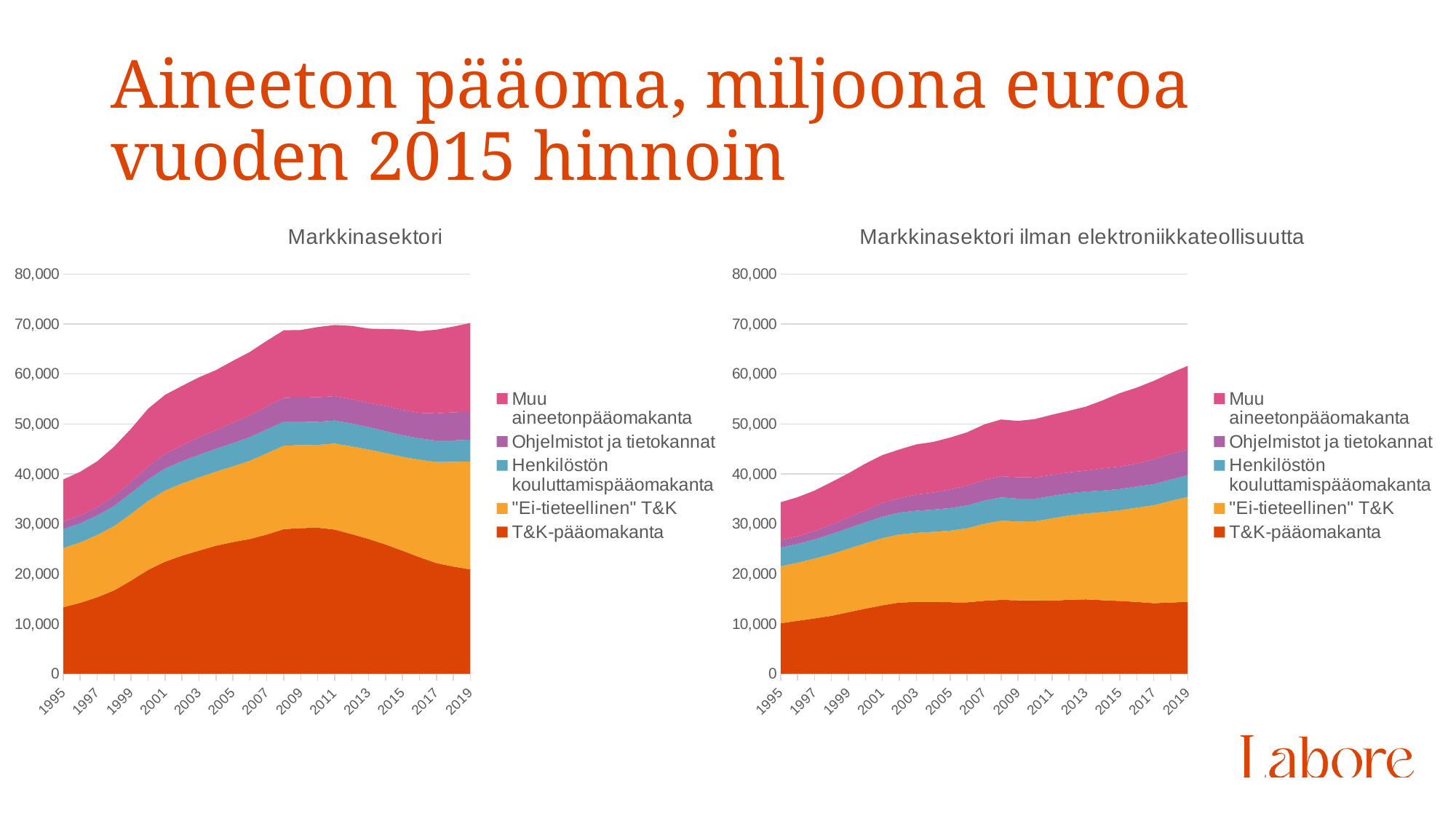
In the "Markkinasektori ilman elektroniikkateollisuutta" chart, does the total stacked value rise or fall from 1995 to 2019? rise In the "Markkinasektori" chart, does the T&K-pääomakanta series rise or fall from 2009 to 2019? fall In the "Markkinasektori ilman elektroniikkateollisuutta" chart, is the total stacked value in 1995 greater or less than 40,000? less In the "Markkinasektori" chart, is the total stacked value in 1995 greater or less than 40,000? less What is the title of the chart on the right? Markkinasektori ilman elektroniikkateollisuutta In the "Markkinasektori ilman elektroniikkateollisuutta" chart, is the total stacked value in 2019 greater or less than 60,000? greater How many year labels are shown on the x axis of the "Markkinasektori" chart? 13 What kind of chart is the "Markkinasektori" chart on the left? stacked area chart In the "Markkinasektori" chart, which series is shown in pink at the top of the stack? Muu aineetonpääomakanta Which chart has the larger total stacked value in 2019, "Markkinasektori" or "Markkinasektori ilman elektroniikkateollisuutta"? Markkinasektori How many series does the legend of the "Markkinasektori" chart list? 5